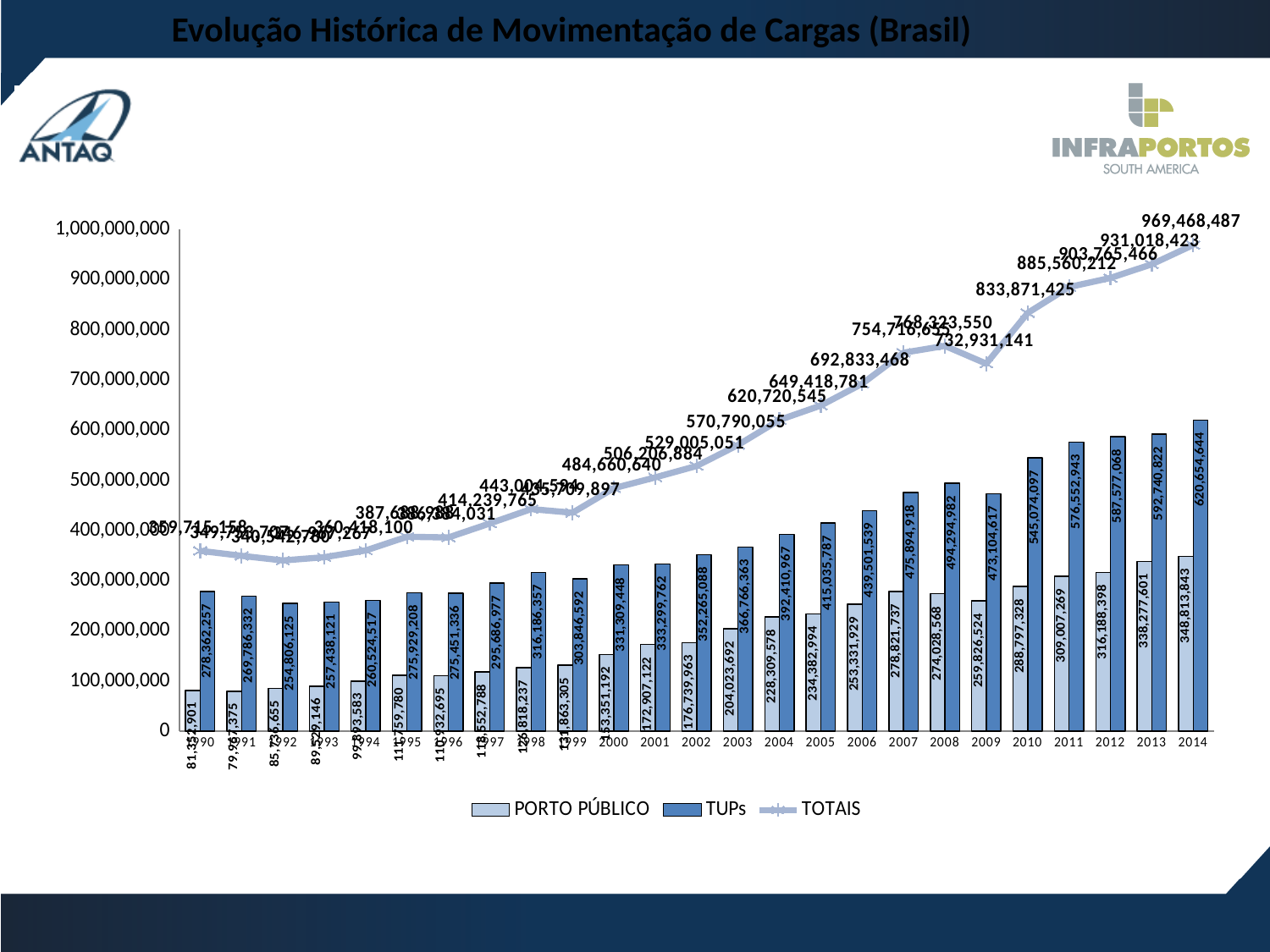
What is the TUPs value for 2014? 620,654,644 What is the PORTO PÚBLICO value for 2010? 288,797,328 In which year is the TUPs value highest? 2014 How many years are shown on the x axis? 25 What is the difference between the TUPs values for 2014 and 2013? 27,913,822 How many series does the legend list? 3 Does the TOTAIS line generally rise or fall from 1990 to 2014? rise In which year is the TOTAIS value lowest? 1992 Is the TUPs value for 2010 greater or less than 500,000,000? greater Which year has the larger TUPs value, 2008 or 2009? 2008 What is the TOTAIS value for 2014? 969,468,487 What kind of chart is this? Bar chart with a line series